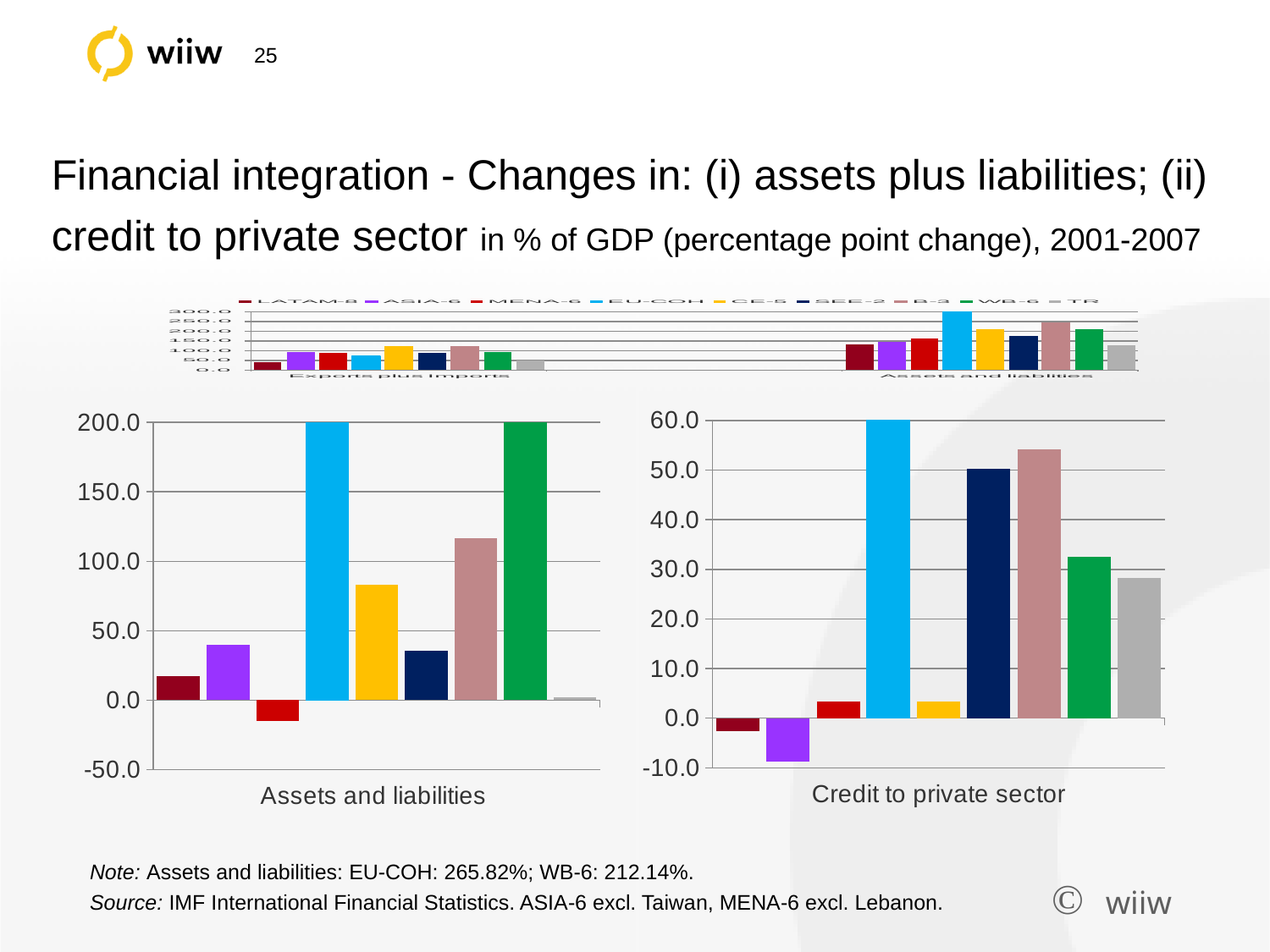
How many bars are plotted in the 'Credit to private sector' chart? 9 In the 'Assets and liabilities' chart, what is the value for EU-COH according to the note? 265.82% In the 'Assets and liabilities' chart, which group has the lowest value? MENA-6 What kind of chart is the 'Assets and liabilities' chart? bar chart In the 'Credit to private sector' chart, is the value for CE-5 greater or less than 10? less In the 'Credit to private sector' chart, which group has the highest value? EU-COH How many series does the legend at the top of the slide list? 9 In the 'Assets and liabilities' chart, which is larger, EU-COH or WB-6? EU-COH In the 'Assets and liabilities' chart, is the value for B-3 greater or less than 100? greater In the 'Assets and liabilities' chart, what is the difference between the EU-COH and WB-6 values given in the note? 53.68 percentage points In the 'Credit to private sector' chart, which group has the lowest value? ASIA-6 In the 'Assets and liabilities' chart, what is the value for WB-6 according to the note? 212.14%